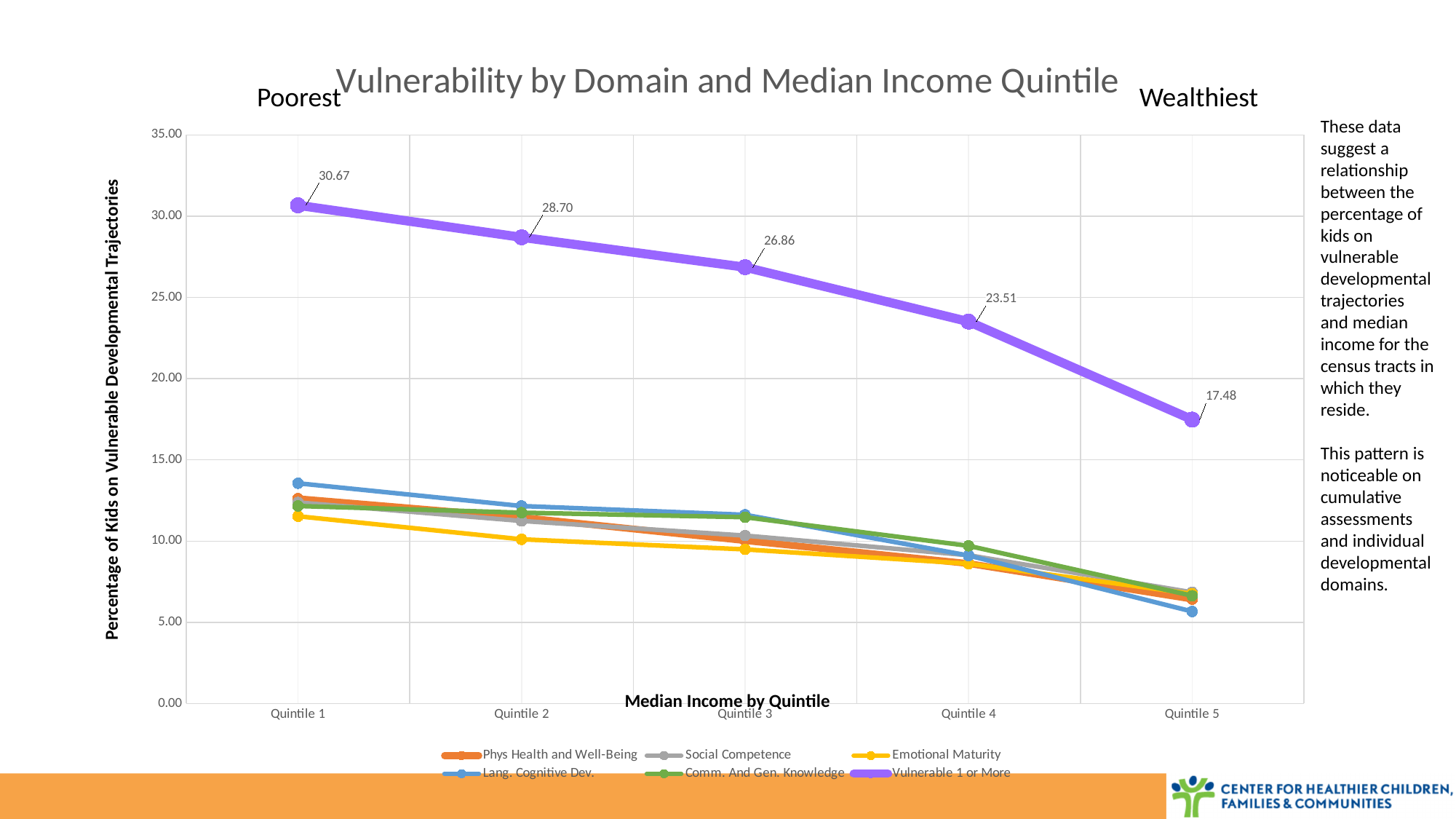
How many series does the legend list? 6 What is the difference between the Vulnerable 1 or More values at Quintile 1 and Quintile 5? 13.19 Does the Vulnerable 1 or More series rise or fall from Quintile 1 to Quintile 5? fall What is the value for Vulnerable 1 or More at Quintile 3? 26.86 At which quintile is the Vulnerable 1 or More series highest? Quintile 1 At which quintile is the Vulnerable 1 or More series lowest? Quintile 5 Is the value for Lang. Cognitive Dev. at Quintile 1 greater or less than 15.00? less What is the difference between the Vulnerable 1 or More values at Quintile 4 and Quintile 5? 6.03 How many quintile categories are shown on the x axis? 5 What is the value for Vulnerable 1 or More at Quintile 1? 30.67 What type of chart is shown on the slide? line chart What is the value for Vulnerable 1 or More at Quintile 5? 17.48